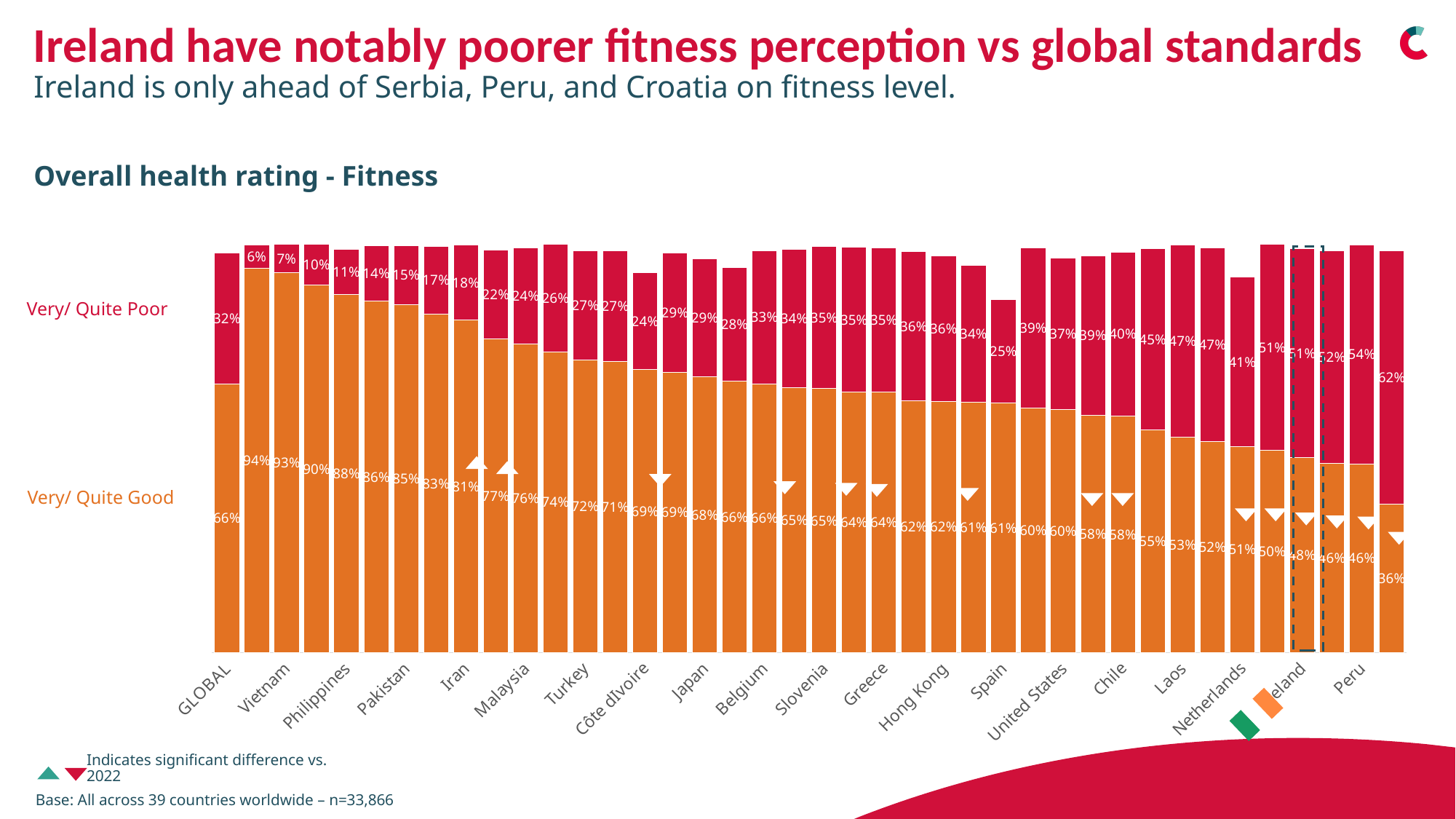
What is the Very/Quite Poor value for GLOBAL? 32% What is the title of the chart? Overall health rating - Fitness What is the Very/Quite Poor value for Ireland? 51% What kind of chart is shown on the slide? Stacked bar chart Which series is shown in orange? Very/ Quite Good What is the Very/Quite Good value for GLOBAL? 66% How many series does the chart show? 2 What is the Very/Quite Good value for Ireland? 48% What is the difference between the Very/Quite Good value for GLOBAL and for Ireland? 18 percentage points What is the Very/Quite Poor value for Peru? 54% Which has the larger Very/Quite Poor value, GLOBAL or Ireland? Ireland Do the Very/Quite Good values rise or fall from left to right across the chart? Fall